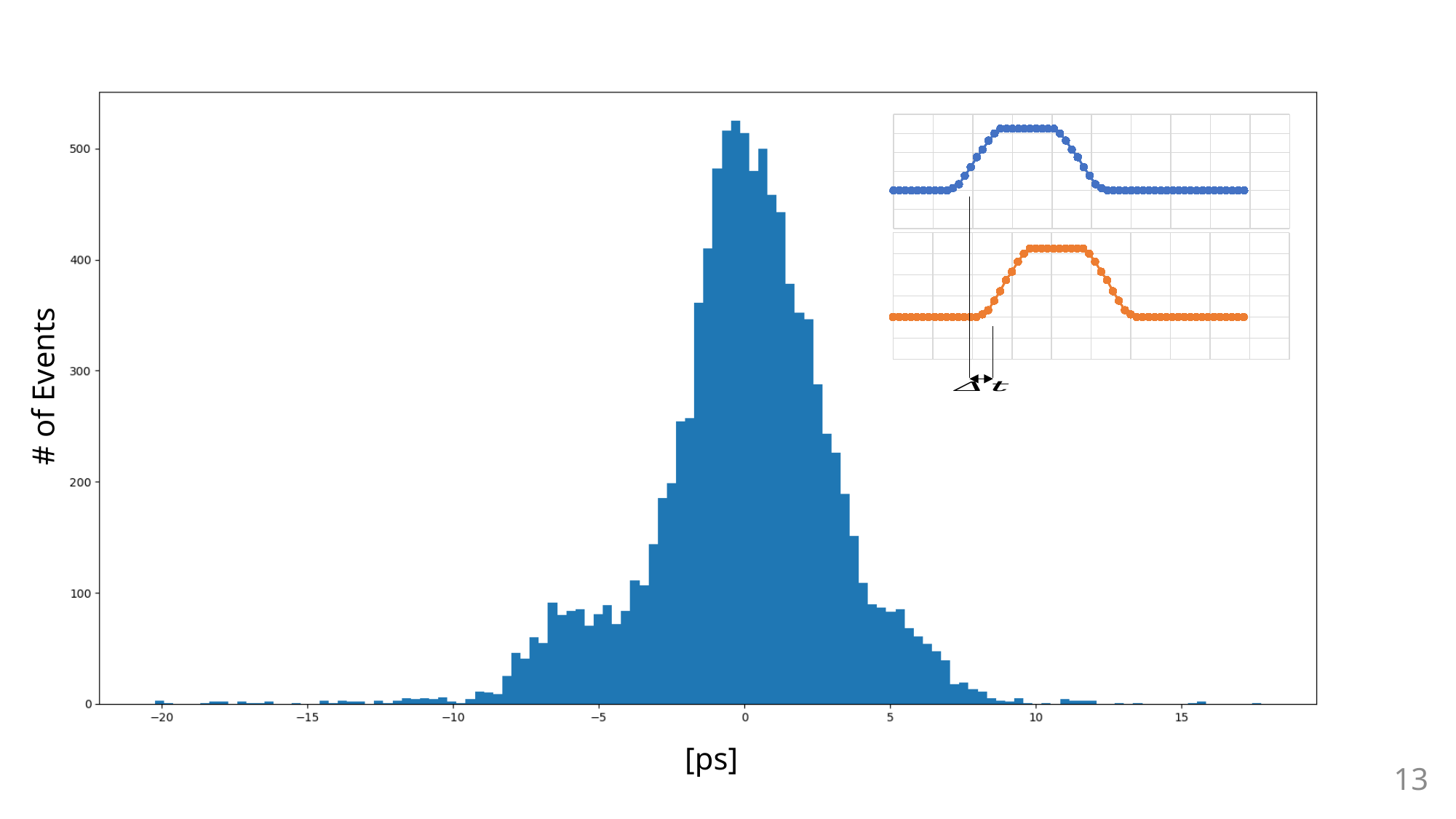
Is the number of events at -5 ps greater or less than 100? less Is the number of events at 4 ps greater or less than 200? less Do the histogram values rise or fall as the x-axis goes from 0 ps to 15 ps? fall Is the number of events at -10 ps greater or less than 100? less Do the histogram values rise or fall as the x-axis goes from -10 ps to 0 ps? rise What kind of chart is the main plot on the slide? Histogram (bar chart) What is the label of the x-axis of the main chart? [ps] What is the label of the y-axis of the main chart? # of Events Is the tallest bar of the histogram closer to the 0 tick or the 5 tick on the x-axis? 0